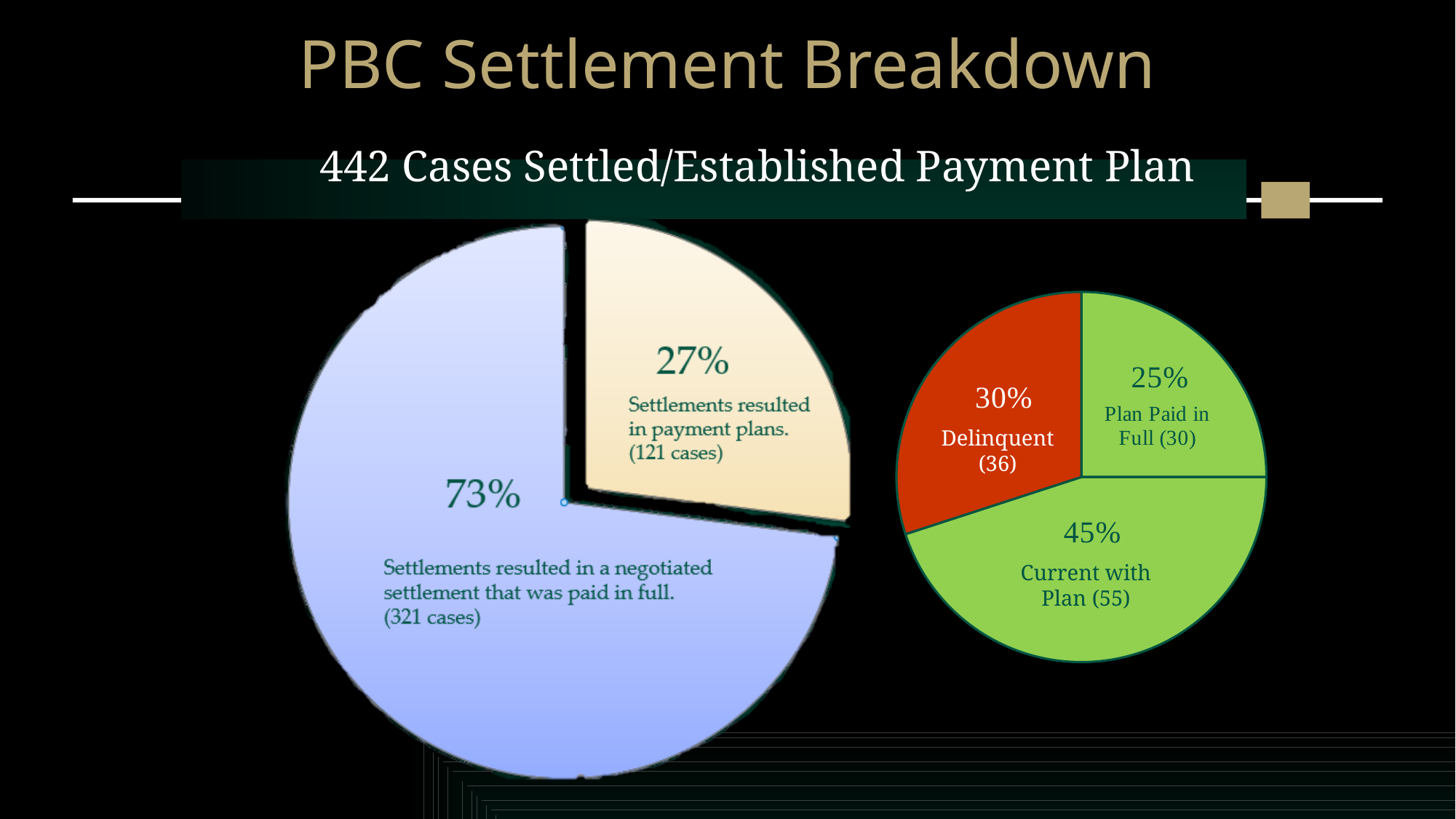
On the left pie chart, what percentage of settlements resulted in payment plans? 27% On the right pie chart, which category has the largest share? Current with Plan On the left pie chart, which slice is larger: settlements paid in full or settlements resulting in payment plans? Settlements paid in full How many slices does the right pie chart have? 3 On the left pie chart, how many cases resulted in a negotiated settlement that was paid in full? 321 cases What is the title of the slide containing the two pie charts? PBC Settlement Breakdown On the right pie chart, how many cases are Current with Plan? 55 On the right pie chart, what percentage is labelled Delinquent? 30% On the right pie chart, which category has the smallest share? Plan Paid in Full On the left pie chart, what is the difference in the number of cases between settlements paid in full and settlements resulting in payment plans? 200 cases What kind of chart is shown on the right side of the slide? Pie chart On the right pie chart, what is the difference in percentage points between Current with Plan and Plan Paid in Full? 20 percentage points